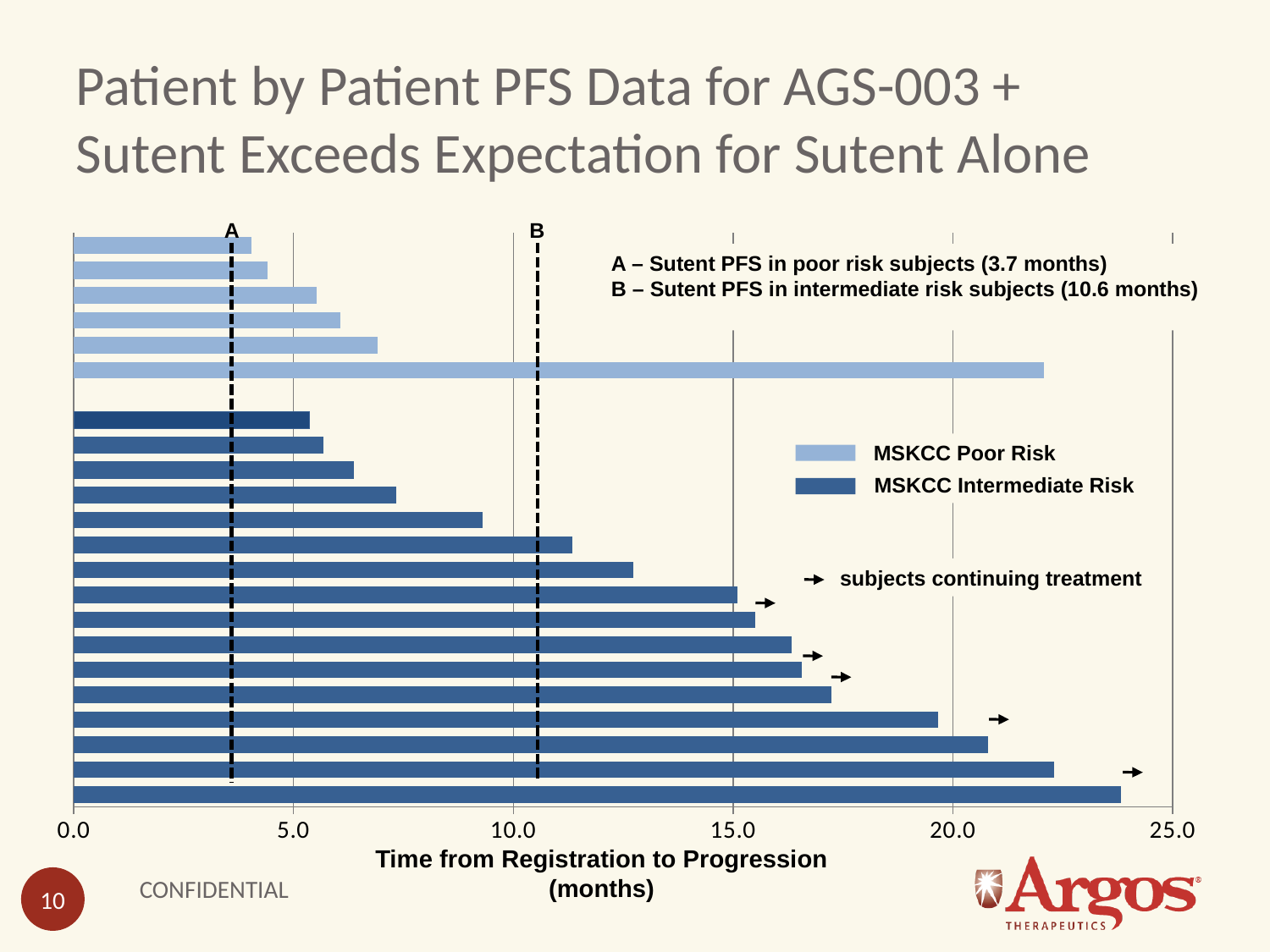
How many series does the legend list? 2 How many MSKCC Poor Risk bars are plotted? 6 What kind of chart is shown on the slide? Bar chart How many bars are plotted in total on the chart? 22 At what value (in months) is reference line A, Sutent PFS in poor risk subjects, drawn? 3.7 months Which series contains the longest bar on the chart, MSKCC Poor Risk or MSKCC Intermediate Risk? MSKCC Intermediate Risk At what value (in months) is reference line B, Sutent PFS in intermediate risk subjects, drawn? 10.6 months How many MSKCC Intermediate Risk bars are plotted? 16 Is the shortest MSKCC Poor Risk bar greater or less than 5.0 months? less What is the title of the x axis? Time from Registration to Progression (months) What are the two series named in the legend? MSKCC Poor Risk and MSKCC Intermediate Risk Is the longest MSKCC Poor Risk bar greater or less than 20.0 months? greater